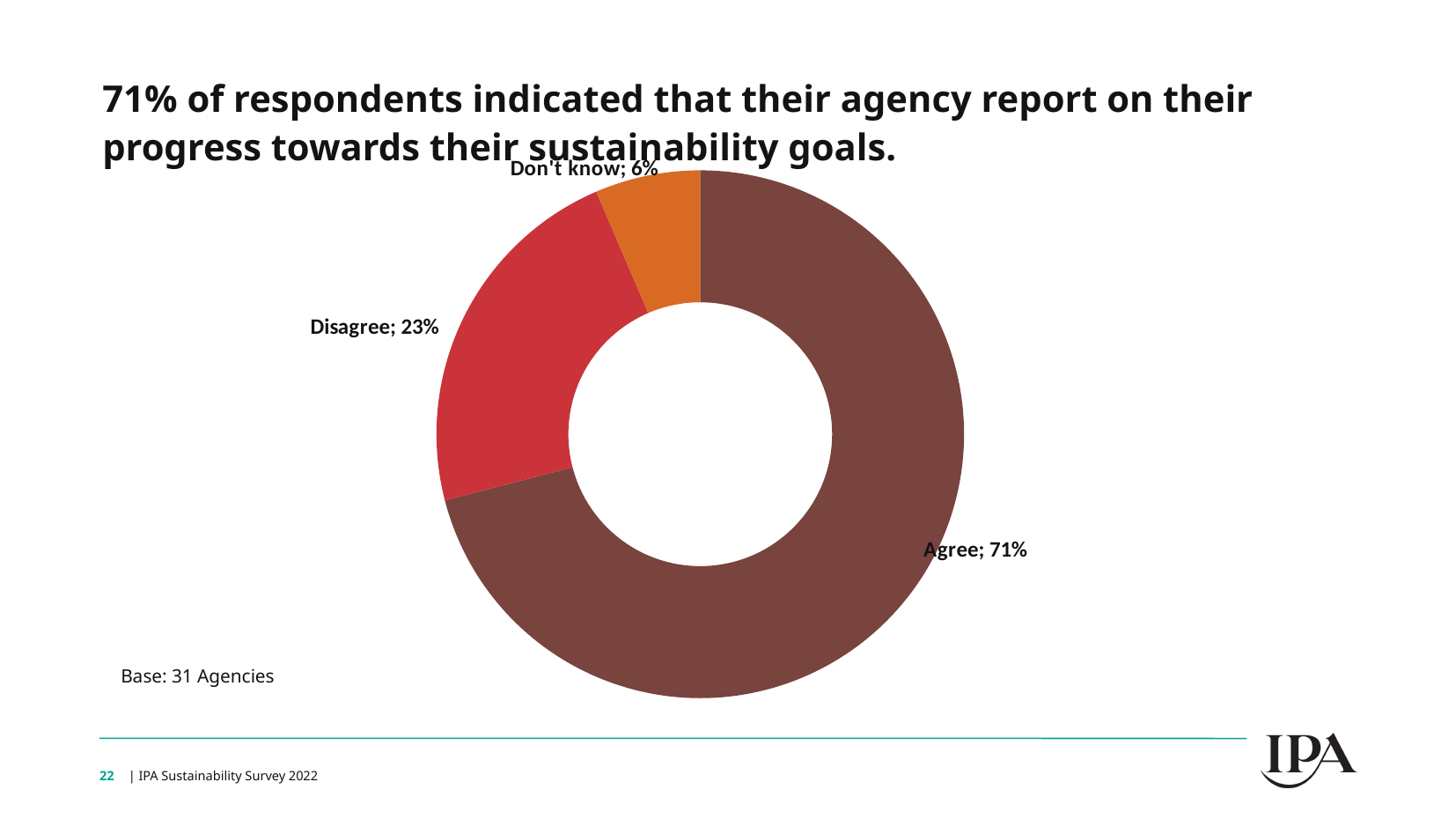
What is the difference in percentage points between Disagree and Don't know? 17 Which category has the smallest share of the chart? Don't know What is the base (number of agencies) stated on the slide? 31 Agencies How many categories are shown in the chart? 3 What is the difference in percentage points between Agree and Disagree? 48 What colour is the Agree segment of the chart? Brown What percentage of respondents answered Don't know? 6% What kind of chart is shown on the slide? Pie chart (doughnut) What percentage of respondents answered Agree? 71% Which category has the largest share of the chart? Agree What percentage of respondents answered Disagree? 23% Which is larger, the share for Disagree or the share for Don't know? Disagree